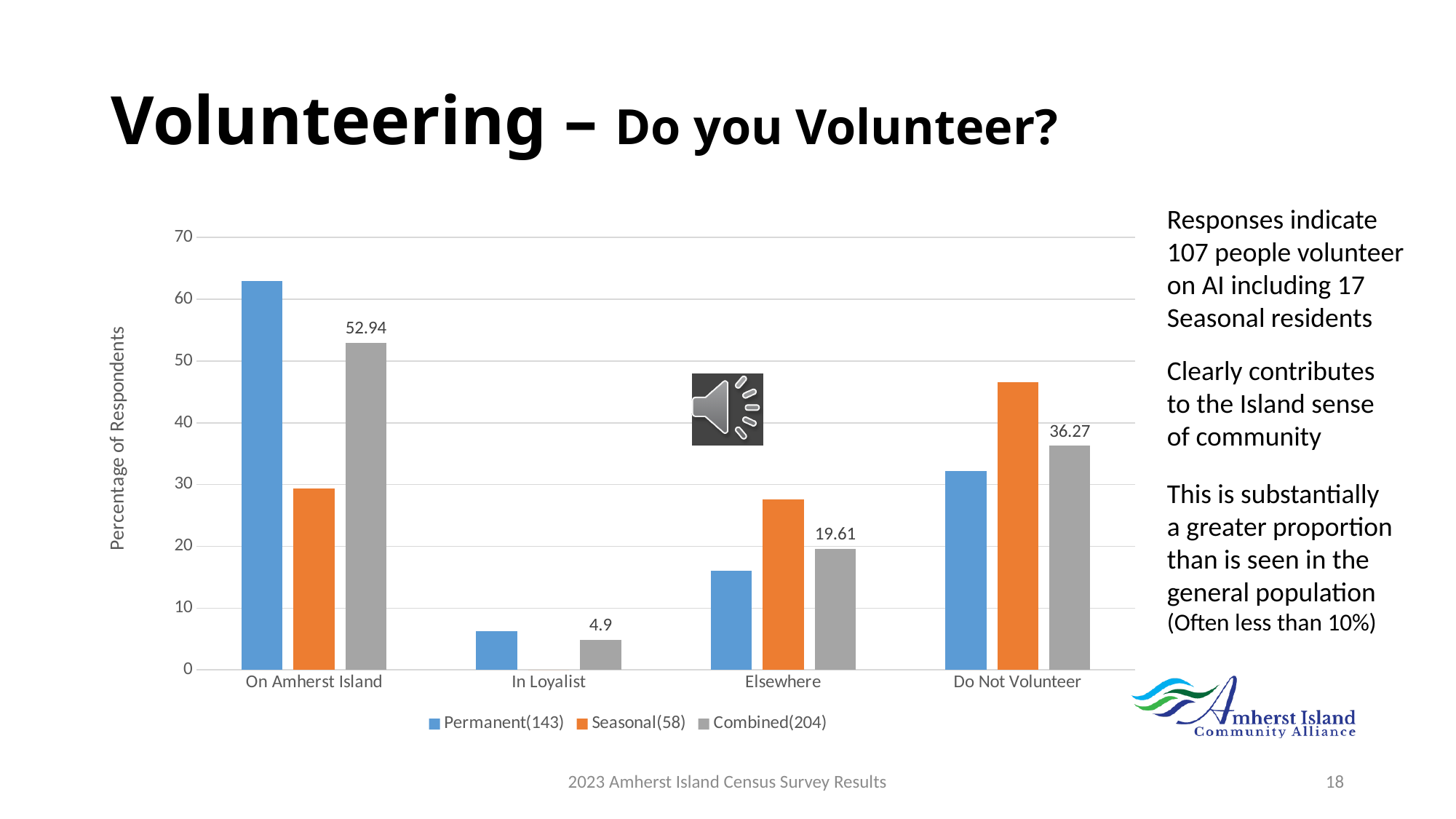
How many categories are shown on the x axis? 4 What is the Combined(204) value for Do Not Volunteer? 36.27 Is the Seasonal(58) value for Do Not Volunteer greater or less than 40? greater Which category has the highest Combined(204) value? On Amherst Island Is the Permanent(143) value for On Amherst Island greater or less than 60? greater For On Amherst Island, which is larger: the Permanent(143) value or the Seasonal(58) value? Permanent(143) Which category has the lowest Combined(204) value? In Loyalist What is the Combined(204) value for In Loyalist? 4.9 What is the Combined(204) value for On Amherst Island? 52.94 What is the difference between the Combined(204) values for On Amherst Island and Do Not Volunteer? 16.67 What is the Combined(204) value for Elsewhere? 19.61 How many series does the legend list? 3